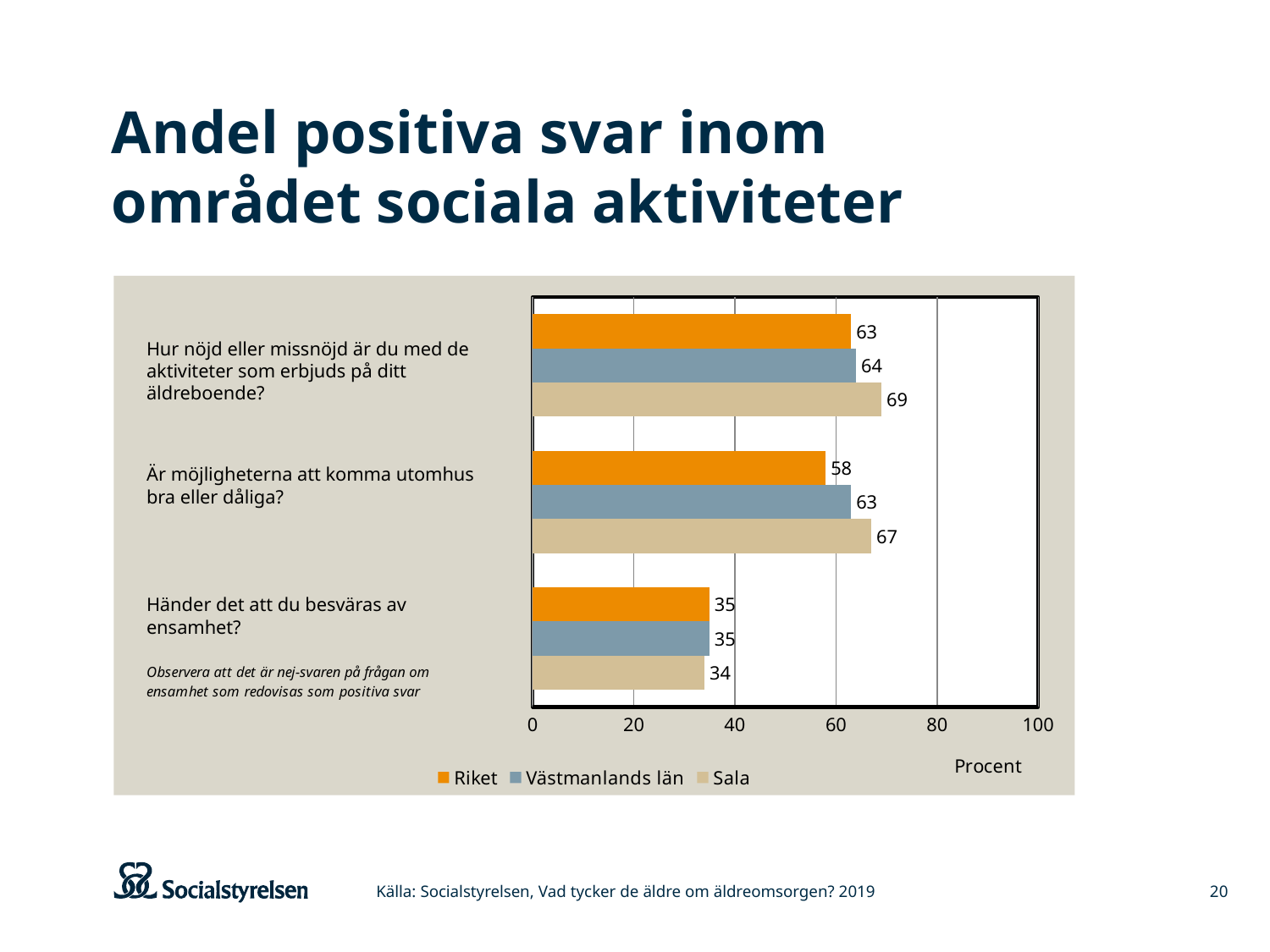
Which question has the lowest value for Sala? Händer det att du besväras av ensamhet? What is the difference between Sala and Västmanlands län on the question "Hur nöjd eller missnöjd är du med de aktiviteter som erbjuds på ditt äldreboende?"? 5 What is the value for Västmanlands län on the question "Händer det att du besväras av ensamhet?"? 35 What is the label of the horizontal axis? Procent What is the value for Sala on the question "Hur nöjd eller missnöjd är du med de aktiviteter som erbjuds på ditt äldreboende?"? 69 Which series has the highest value on the question "Är möjligheterna att komma utomhus bra eller dåliga?"? Sala What is the value for Riket on the question "Är möjligheterna att komma utomhus bra eller dåliga?"? 58 How many series does the legend list? 3 Which is larger: Riket or Västmanlands län on the question "Är möjligheterna att komma utomhus bra eller dåliga?"? Västmanlands län How many question categories are shown on the chart? 3 What kind of chart is shown on the slide? Bar chart What is the difference between Sala and Riket on the question "Är möjligheterna att komma utomhus bra eller dåliga?"? 9